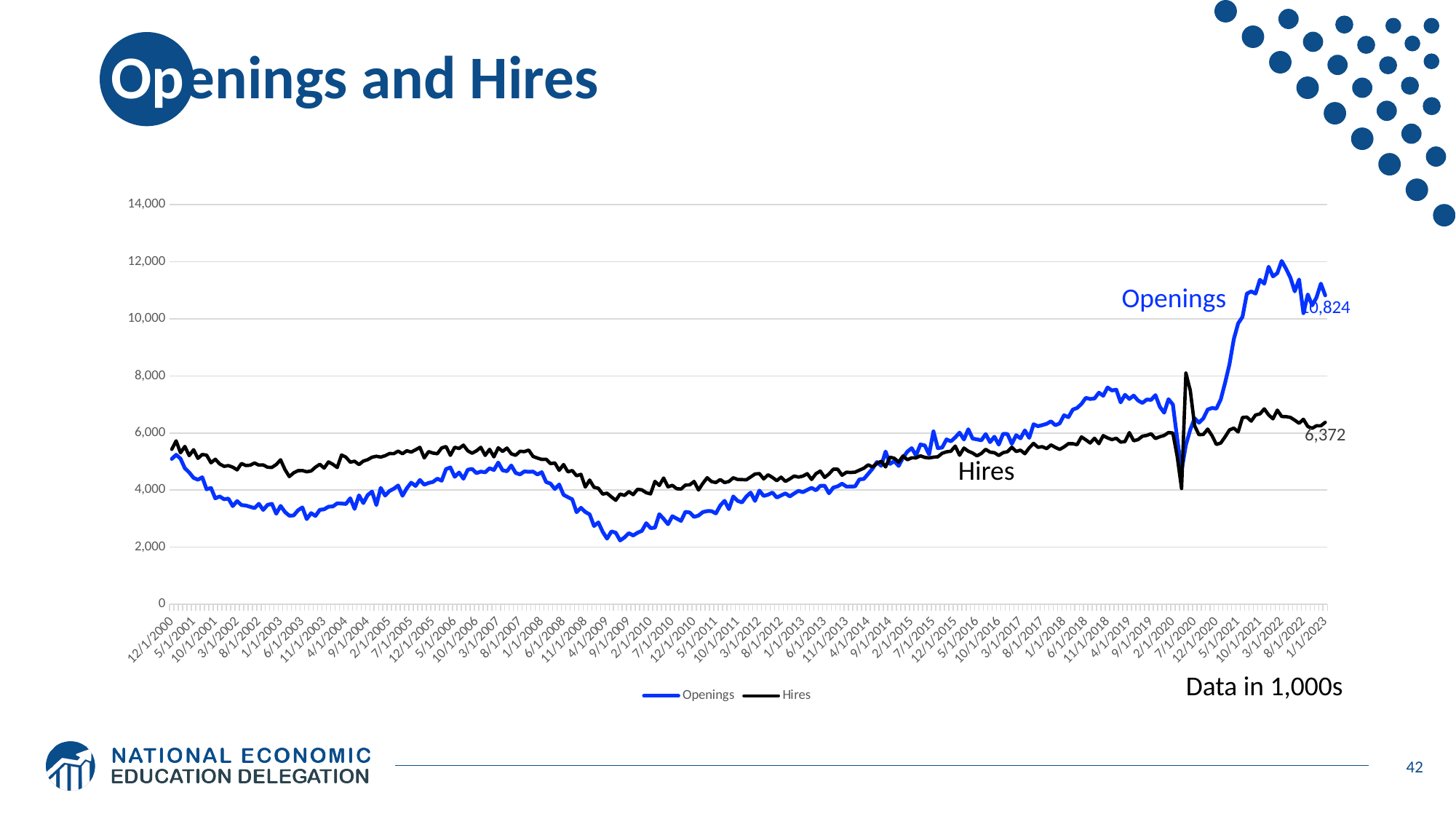
What is the difference between the final labelled Openings value and the final labelled Hires value? 4,452 What colour is the Openings line? Blue Is the peak value of Openings in 2022 greater or less than 10,000? greater Is the value for Hires at 12/1/2000 greater or less than 4,000? greater What is the last labelled value of the Openings series? 10,824 According to the note on the slide, in what units is the data shown? Data in 1,000s At the end of the series, which is larger: Openings or Hires? Openings Did Openings rise or fall between 9/1/2009 and 3/1/2022? Rise Is the value for Openings around 9/1/2009 greater or less than 4,000? less How many series does the legend list? 2 What is the last labelled value of the Hires series? 6,372 What kind of chart is shown on the slide? Line chart